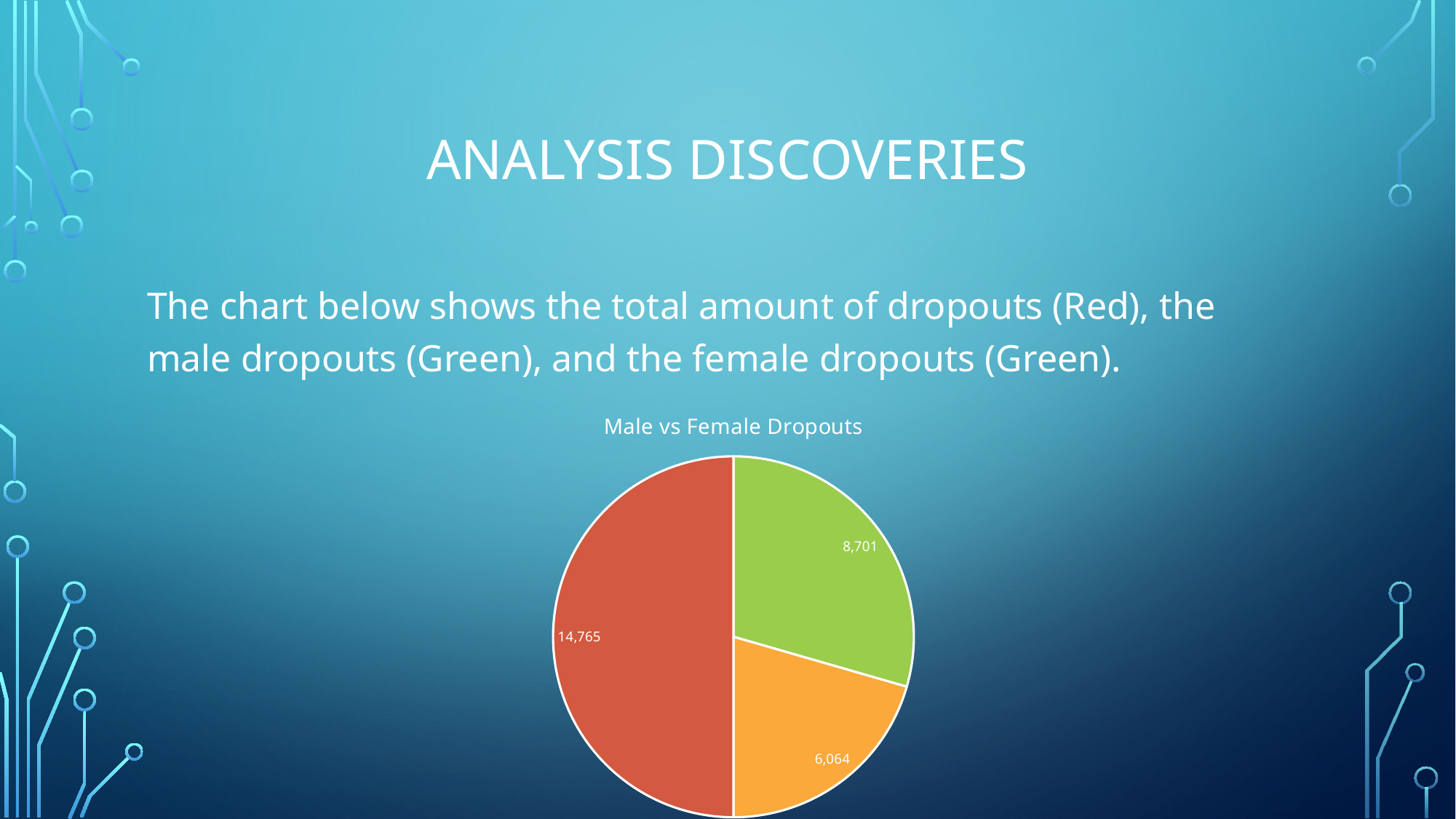
What kind of chart is shown on the slide? Pie chart What is the difference between the green slice value and the orange slice value? 2,637 What is the title of the chart? Male vs Female Dropouts Which is larger, the green slice value or the orange slice value? The green slice (8,701) What value is shown on the red slice of the pie chart? 14,765 What value is shown on the orange slice of the pie chart? 6,064 Which slice of the pie chart has the largest value? The red slice (14,765) What value is shown on the green slice of the pie chart? 8,701 What share of the whole pie does the red slice represent? 50% How many slices does the pie chart have? 3 Which slice of the pie chart has the smallest value? The orange slice (6,064) According to the slide text, what does the red slice represent? The total amount of dropouts